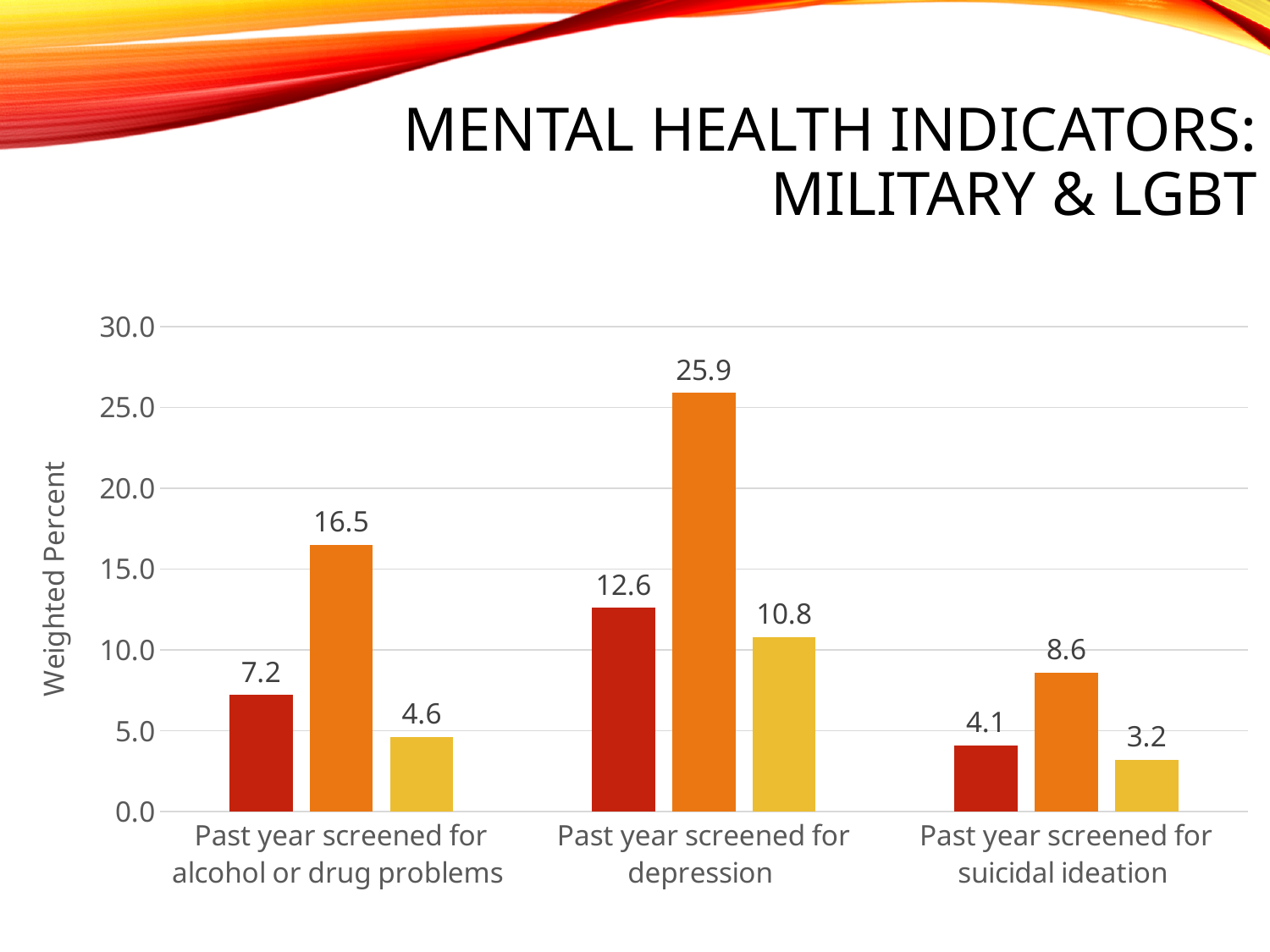
What is the difference between the orange bar and the yellow bar for 'Past year screened for alcohol or drug problems'? 11.9 What is the value of the dark red bar for 'Past year screened for alcohol or drug problems'? 7.2 How many categories are shown on the x axis? 3 What is the value of the yellow bar for 'Past year screened for suicidal ideation'? 3.2 Which category has the lowest yellow bar? Past year screened for suicidal ideation What is the value of the orange bar for 'Past year screened for depression'? 25.9 What is the value of the yellow bar for 'Past year screened for depression'? 10.8 Which category has the highest orange bar? Past year screened for depression What is the difference between the orange bar and the dark red bar for 'Past year screened for depression'? 13.3 What kind of chart is shown on the slide? Bar chart What is the label of the vertical axis? Weighted Percent Which is larger: the dark red bar for 'Past year screened for alcohol or drug problems' or the orange bar for 'Past year screened for suicidal ideation'? The orange bar for 'Past year screened for suicidal ideation'